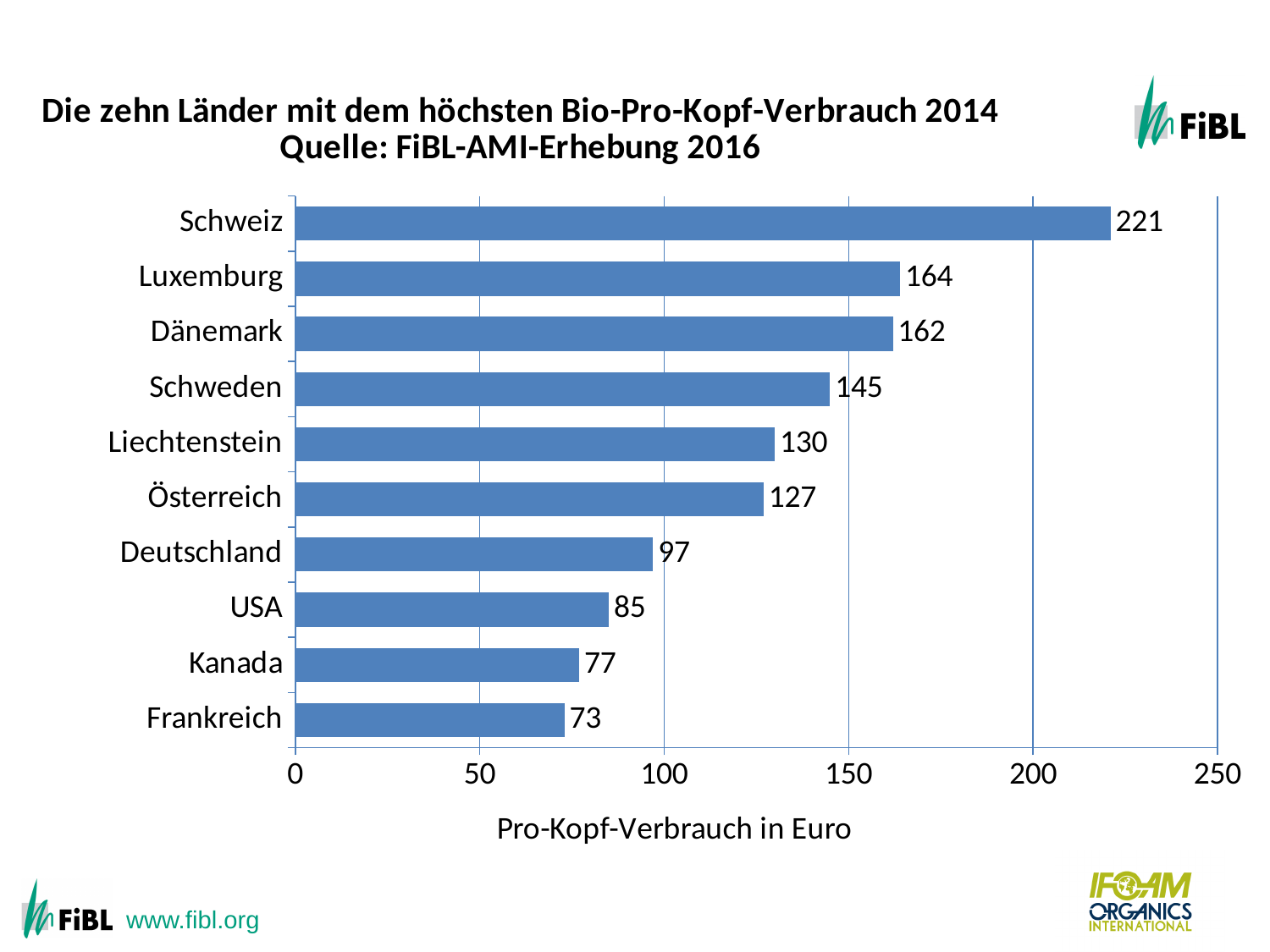
Is the value for Dänemark greater or less than 150? greater What is the difference between the values for USA and Kanada? 8 What is the difference between the values for Schweiz and Luxemburg? 57 Which country has the lowest per-capita consumption in the chart? Frankreich What value is shown for Deutschland? 97 Which has a larger value, Schweden or Österreich? Schweden What is the label of the horizontal axis? Pro-Kopf-Verbrauch in Euro What is the per-capita organic consumption value shown for Schweiz? 221 Which country has the highest per-capita consumption in the chart? Schweiz How many countries are shown in the chart? 10 What value is shown for Liechtenstein? 130 What kind of chart is shown on the slide? bar chart